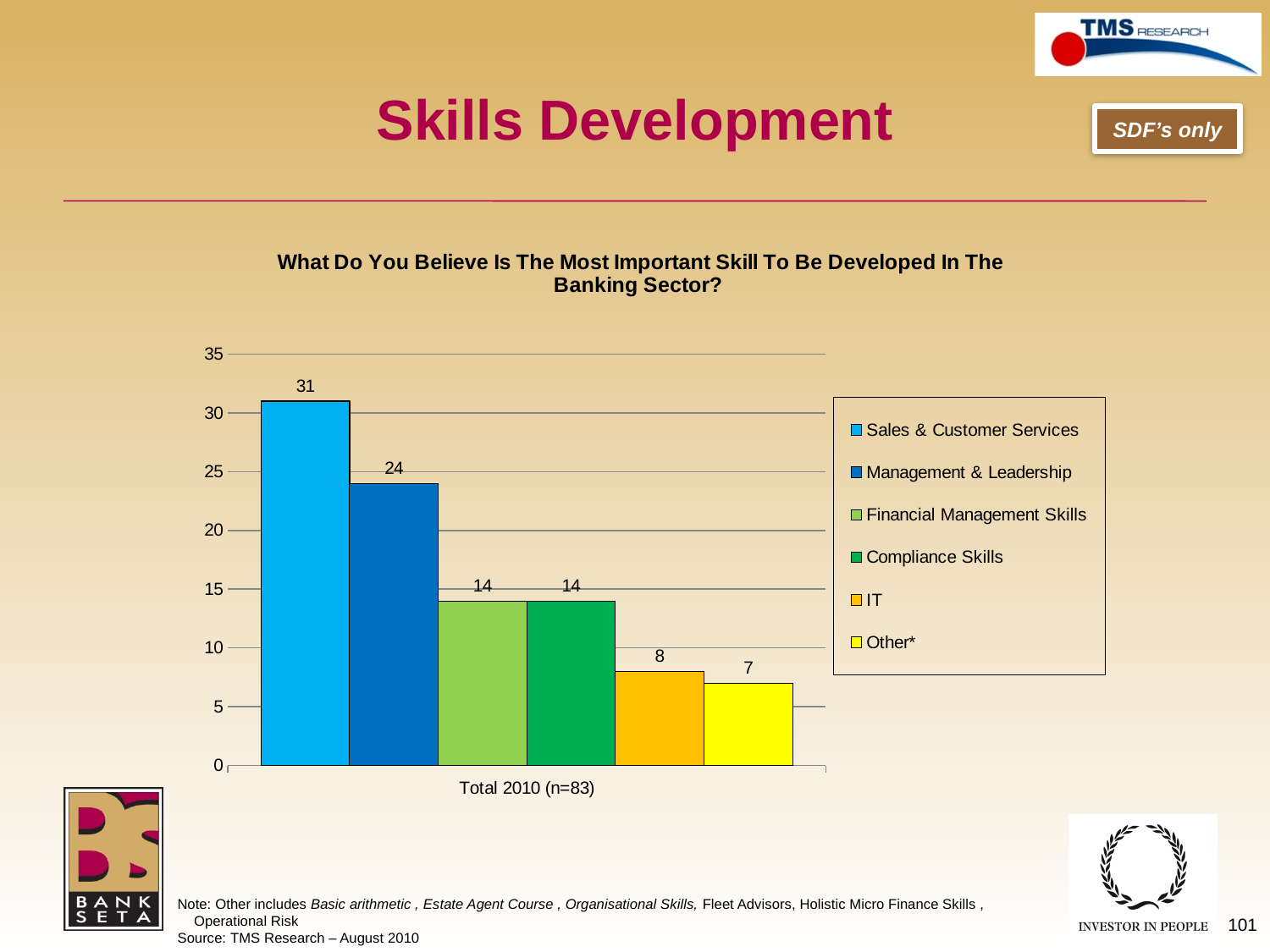
What is the value for Management & Leadership? 24 What is the value for IT? 8 What is the x-axis category label shown under the bars? Total 2010 (n=83) Which is larger, the value for Management & Leadership or the value for Compliance Skills? Management & Leadership Which series has the lowest value? Other* How many series does the legend list? 6 Is the value for Financial Management Skills greater or less than 15? less What kind of chart is shown on the slide? bar chart What is the value for Other*? 7 What is the difference between the values for Sales & Customer Services and Management & Leadership? 7 Which series has the highest value? Sales & Customer Services What is the value for Sales & Customer Services? 31